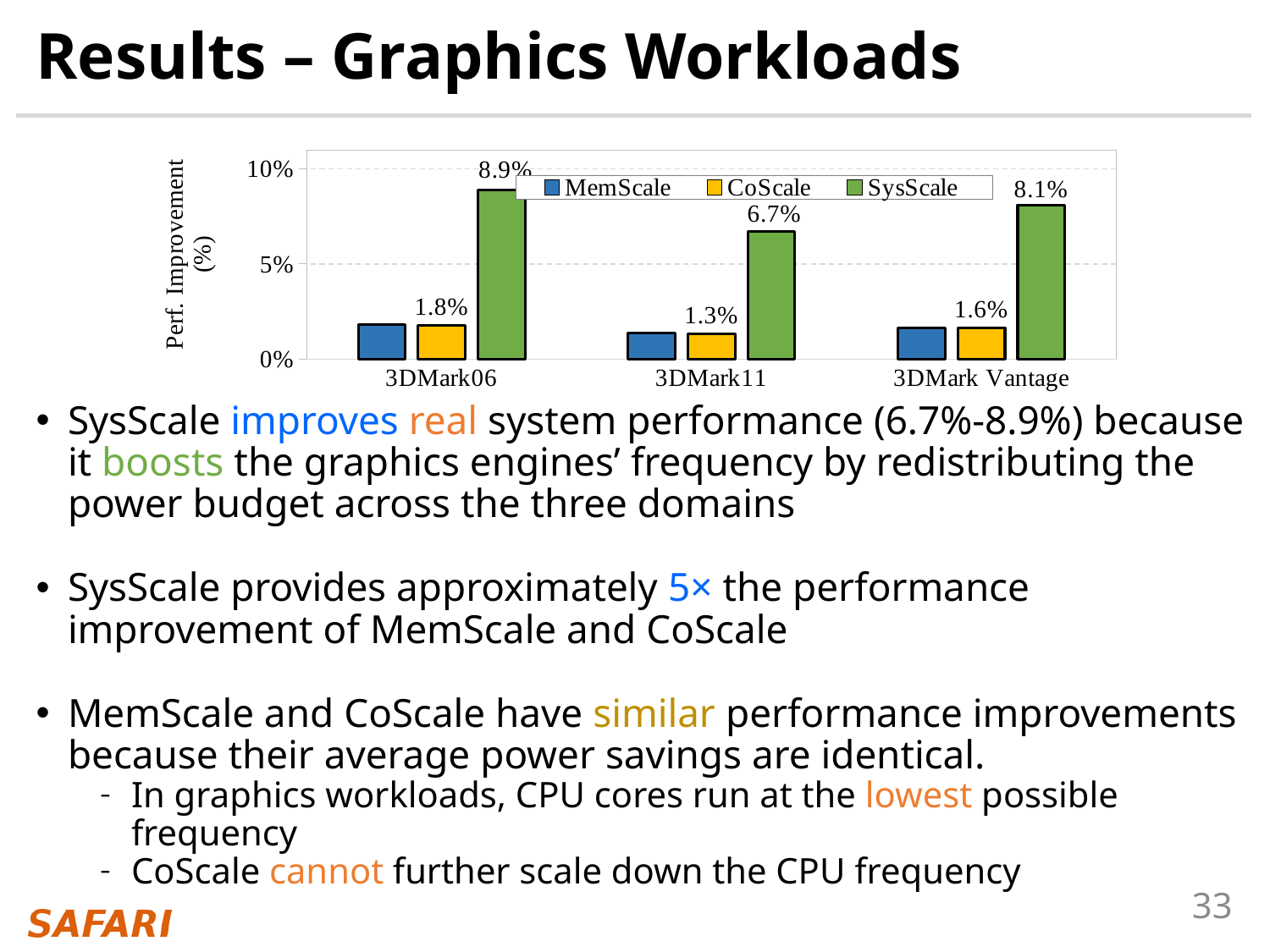
What is the CoScale performance improvement for 3DMark11? 1.3% What is the SysScale performance improvement for 3DMark06? 8.9% For which workload does SysScale achieve its lowest performance improvement? 3DMark11 For which workload does SysScale achieve its highest performance improvement? 3DMark06 What type of chart is shown on the slide? bar chart Which is larger for 3DMark Vantage: the SysScale improvement or the CoScale improvement? SysScale What is the SysScale performance improvement for 3DMark11? 6.7% Is the MemScale performance improvement for 3DMark06 greater or less than 5%? less What is the difference between the SysScale performance improvement for 3DMark06 and for 3DMark11? 2.2% How many series does the chart legend list? 3 How many workloads are shown on the x axis of the chart? 3 What is the SysScale performance improvement for 3DMark Vantage? 8.1%